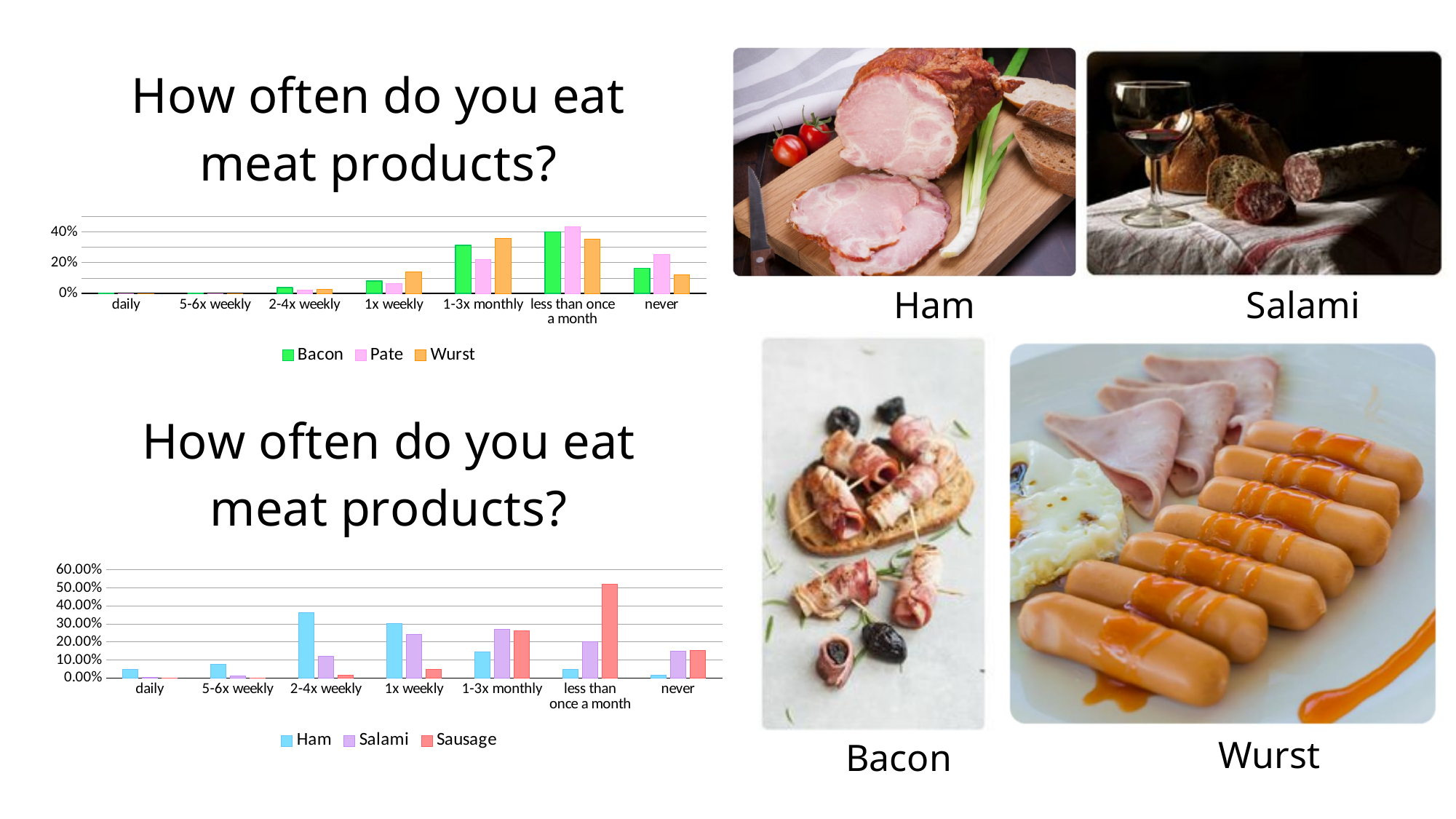
In the top chart, which is larger at never: Bacon or Pate? Pate In the top chart, which series has the lowest value at never? Wurst In the top chart, which category has the highest value for Bacon? less than once a month What kind of chart is the top chart? bar chart In the bottom chart, what are the legend entries? Ham, Salami, Sausage In the top chart, how many series does the legend list? 3 In the bottom chart, which is larger at 1x weekly: Ham or Salami? Ham In the bottom chart, which category has the highest value for Sausage? less than once a month In the top chart, is the value for Wurst at 1-3x monthly greater or less than 20%? greater In the bottom chart, is the value for Sausage at less than once a month greater or less than 40.00%? greater In the bottom chart, is the value for Ham at 2-4x weekly greater or less than 30.00%? greater How many categories are shown on the x axis of the bottom chart? 7